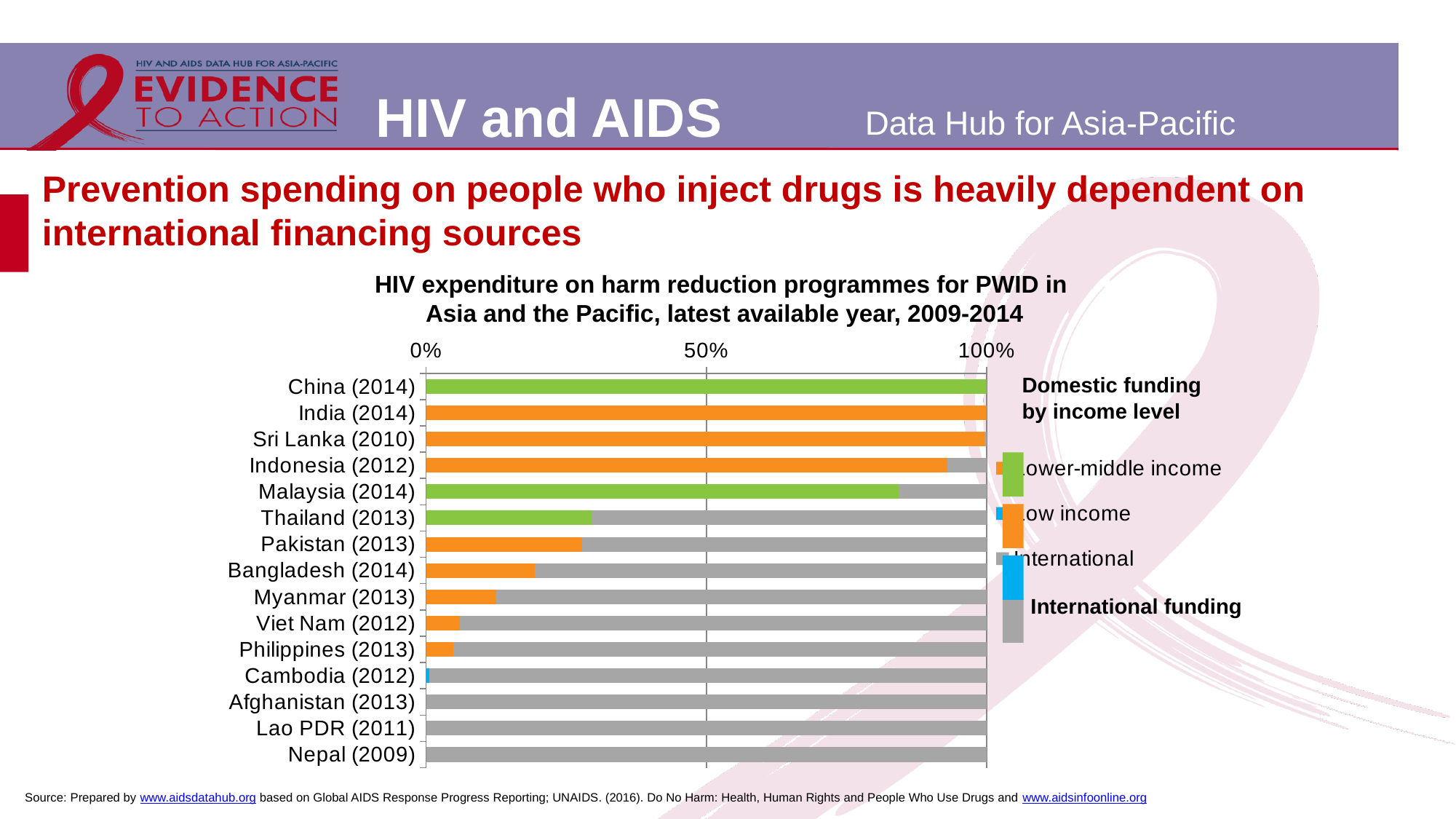
What kind of chart is shown on the slide? Stacked bar chart Which year is shown next to Nepal on the chart? 2009 Is the domestic funding share for Indonesia (2012) greater or less than 50%? greater Is the domestic funding share for Malaysia (2014) greater or less than 50%? greater Which has a larger domestic funding share, Malaysia (2014) or Thailand (2013)? Malaysia (2014) Which has a larger domestic funding share, Pakistan (2013) or Bangladesh (2014)? Pakistan (2013) Is the international funding share for Bangladesh (2014) greater or less than 50%? greater How many countries are listed on the chart? 15 What is the title of the chart? HIV expenditure on harm reduction programmes for PWID in Asia and the Pacific, latest available year, 2009-2014 Which has a larger international funding share, Viet Nam (2012) or Myanmar (2013)? Viet Nam (2012)